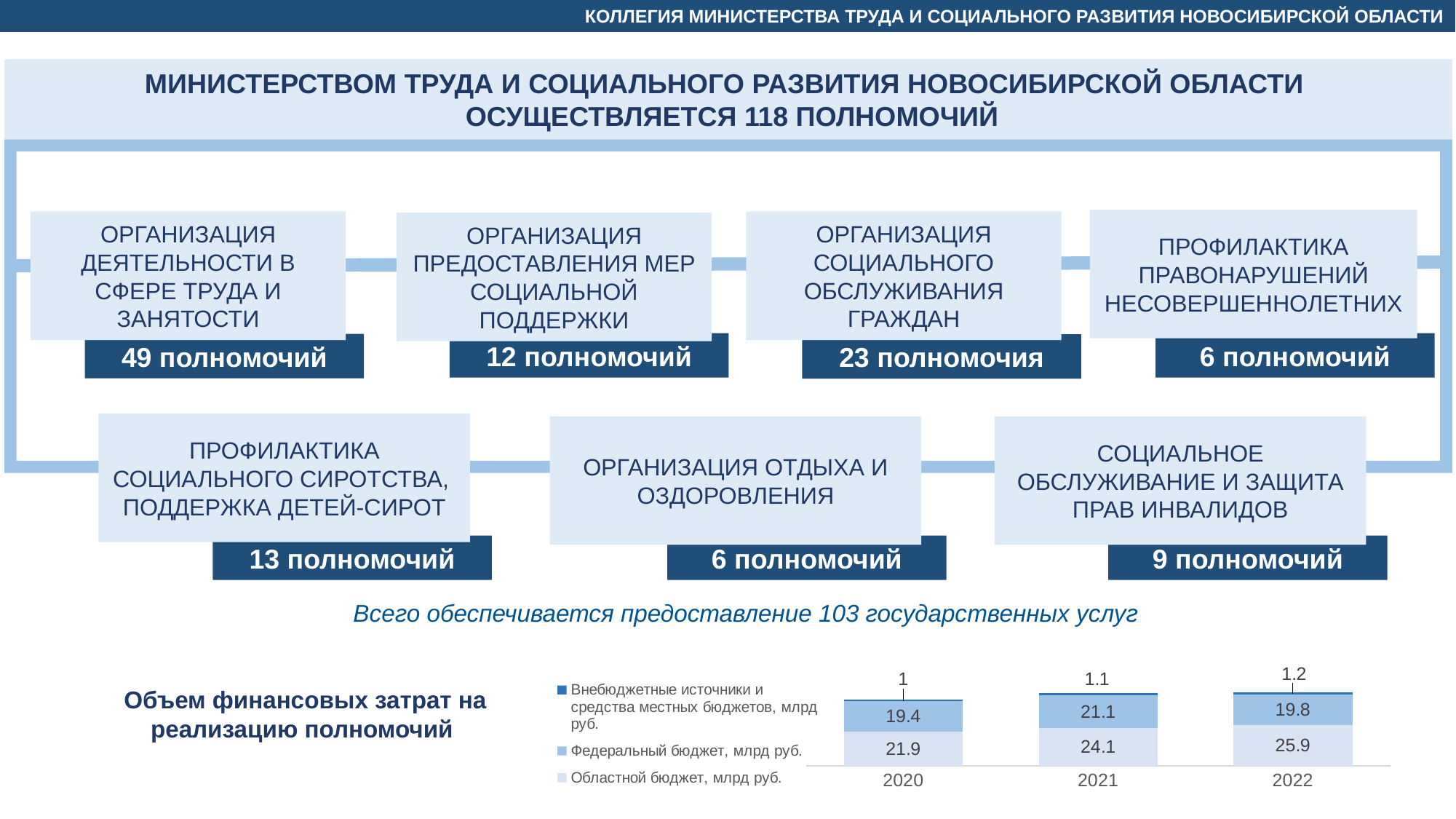
In the chart "Объем финансовых затрат на реализацию полномочий", how many years are shown on the x axis? 3 In the chart "Объем финансовых затрат на реализацию полномочий", what is the value of Областной бюджет for 2022? 25.9 In the chart "Объем финансовых затрат на реализацию полномочий", how many series does the legend list? 3 In the chart "Объем финансовых затрат на реализацию полномочий", what is the difference between the Областной бюджет values for 2021 and 2020? 2.2 In the chart "Объем финансовых затрат на реализацию полномочий", which year has the highest value for Областной бюджет? 2022 What type of chart is shown at the bottom of the slide under "Объем финансовых затрат на реализацию полномочий"? Stacked bar chart In the chart "Объем финансовых затрат на реализацию полномочий", which year has the lowest value for Федеральный бюджет? 2020 In the chart "Объем финансовых затрат на реализацию полномочий", what is the value of Федеральный бюджет for 2021? 21.1 In the chart "Объем финансовых затрат на реализацию полномочий", what is the total of the stacked bar for 2020? 42.3 In the chart "Объем финансовых затрат на реализацию полномочий", what is the value of Внебюджетные источники и средства местных бюджетов for 2020? 1 In the chart "Объем финансовых затрат на реализацию полномочий", do the Областной бюджет values rise or fall from 2020 to 2022? Rise In the chart "Объем финансовых затрат на реализацию полномочий", is the Федеральный бюджет value larger in 2021 or in 2022? 2021